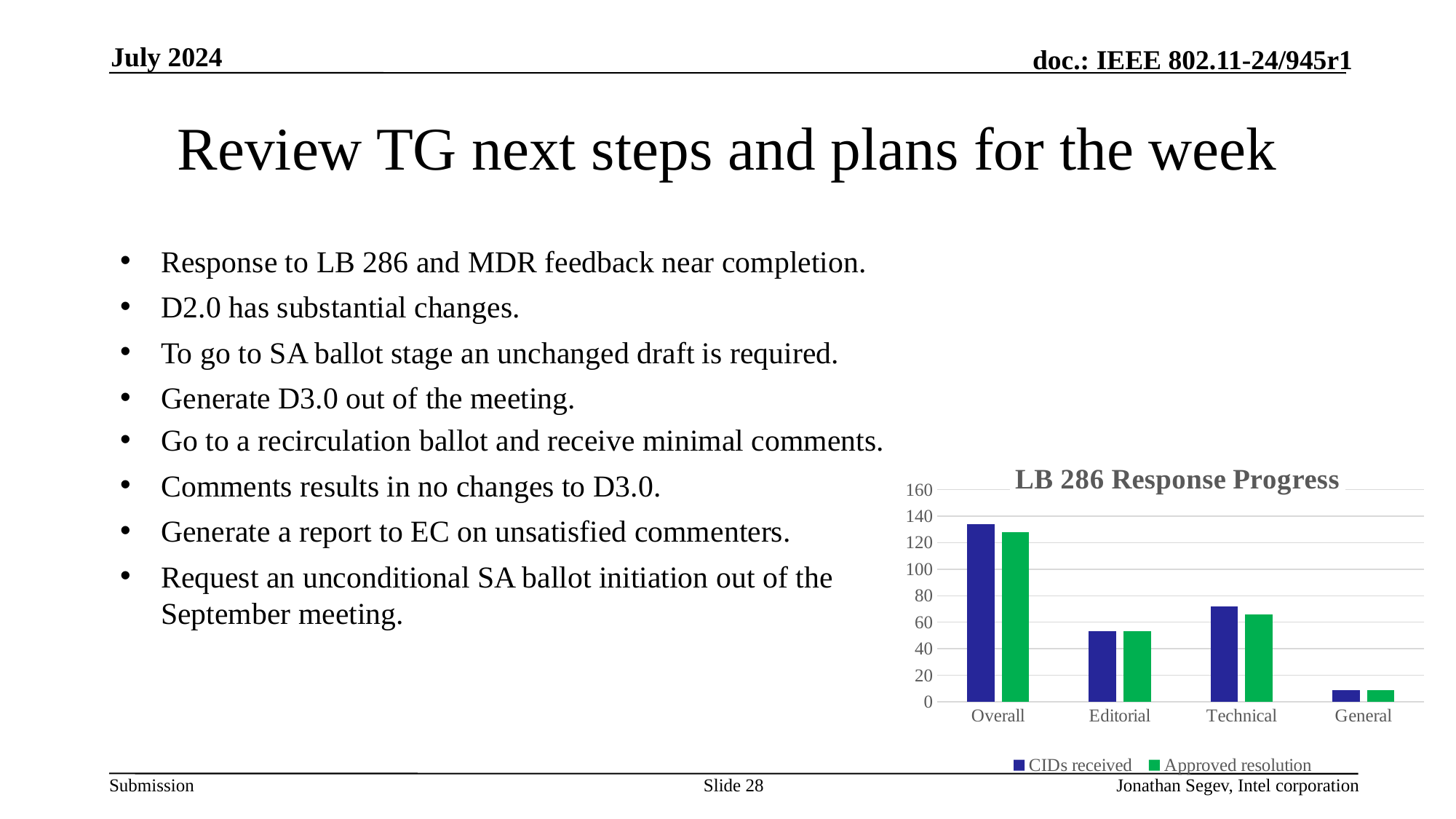
Which category has the lowest value for Approved resolution? General What is the title of the chart? LB 286 Response Progress Is the value for CIDs received in the Overall category greater or less than 120? greater What kind of chart is shown on the slide? bar chart How many series does the chart's legend list? 2 How many categories are shown on the x axis of the chart? 4 Which colour represents the Approved resolution series in the chart? green Is the value for Approved resolution in the Technical category greater or less than 60? greater Is the value for CIDs received in the General category greater or less than 20? less Which category has the highest value for CIDs received? Overall Which is larger: CIDs received for Technical or CIDs received for Editorial? Technical